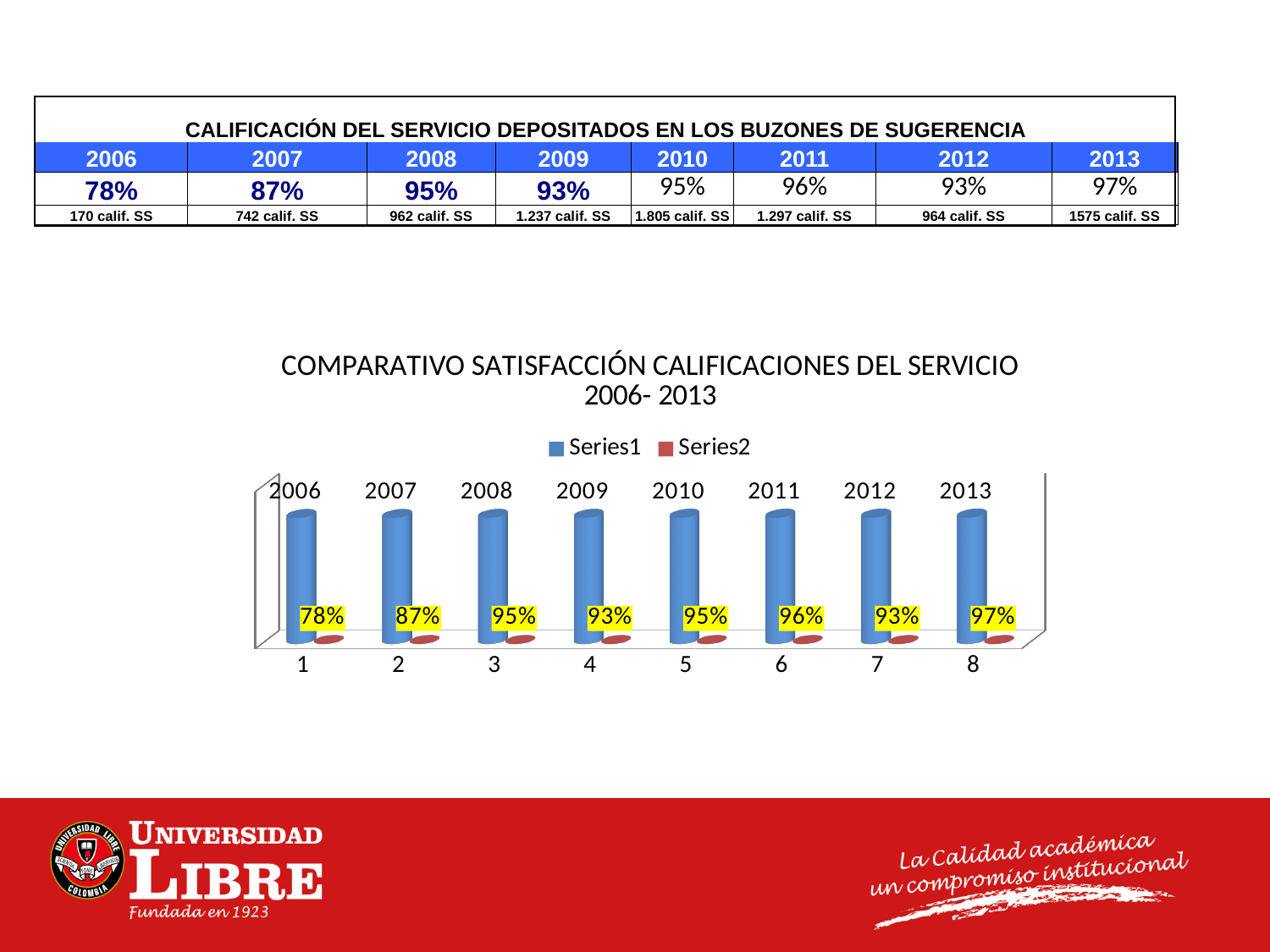
How many series does the chart legend list? 2 Which year has the highest percentage label in the chart? 2013 How many categories are shown along the x axis of the chart? 8 What percentage label is shown for 2011 in the chart? 96% Which year has the lowest percentage label in the chart? 2006 Which has the larger percentage label in the chart, 2007 or 2008? 2008 What percentage label is shown for 2006 in the chart? 78% What are the two entries listed in the chart legend? Series1 and Series2 What kind of chart is shown on the slide? bar chart What is the title of the chart? COMPARATIVO SATISFACCIÓN CALIFICACIONES DEL SERVICIO 2006- 2013 What is the difference between the percentage labels for 2013 and 2006 in the chart? 19% What percentage label is shown for 2013 in the chart? 97%